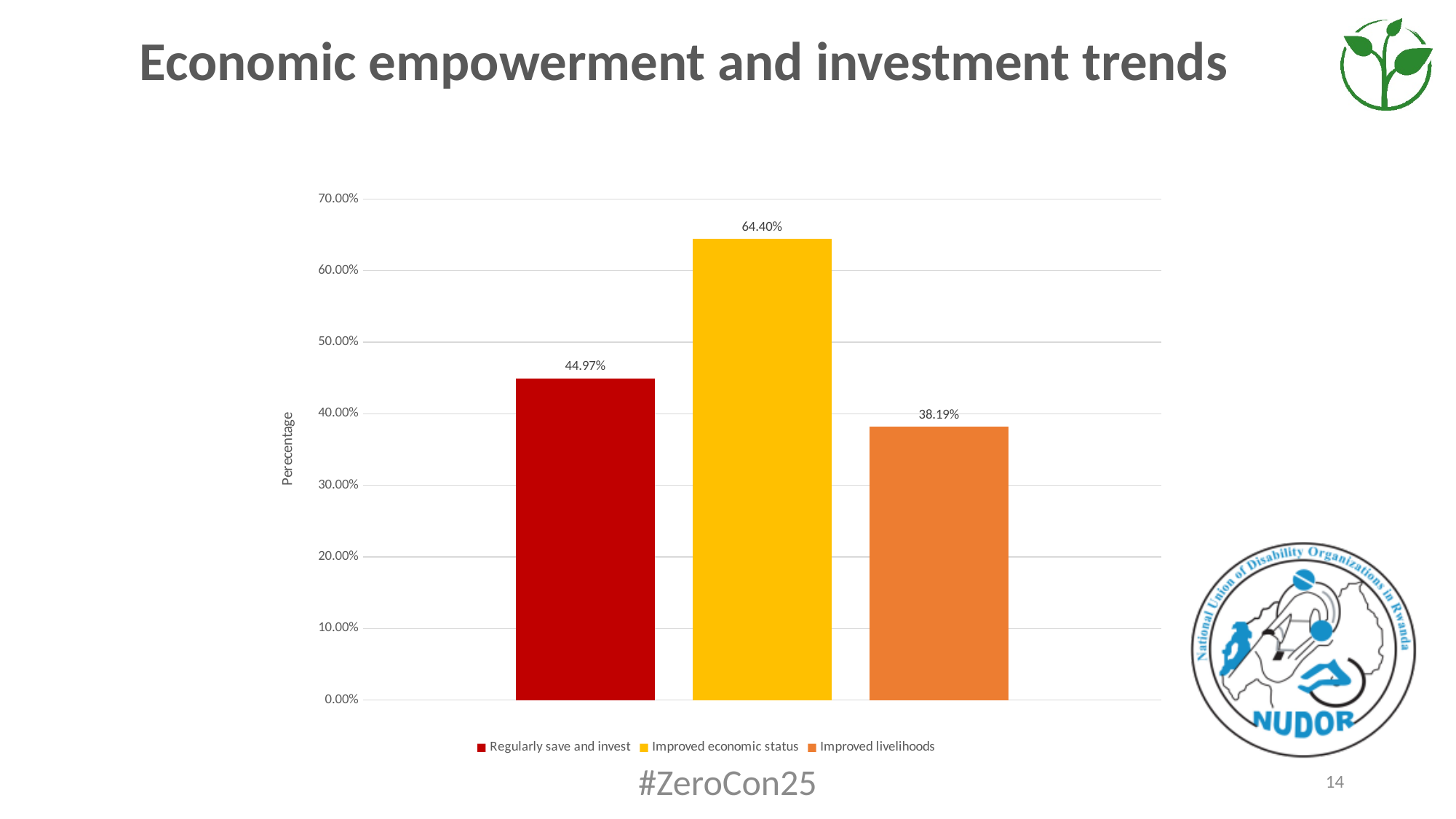
Which category has the highest value? Improved economic status What is the value for Improved economic status? 64.40% Which is larger, Regularly save and invest or Improved livelihoods? Regularly save and invest Which category has the lowest value? Improved livelihoods Is the value for Improved economic status greater or less than 60.00%? greater What is the difference between Regularly save and invest and Improved livelihoods? 6.78% What is the value for Improved livelihoods? 38.19% What kind of chart is shown on the slide? Bar chart How many bars are shown in the chart? 3 What is the value for Regularly save and invest? 44.97% What is the label on the vertical axis? Percentage What is the difference between Improved economic status and Regularly save and invest? 19.43%